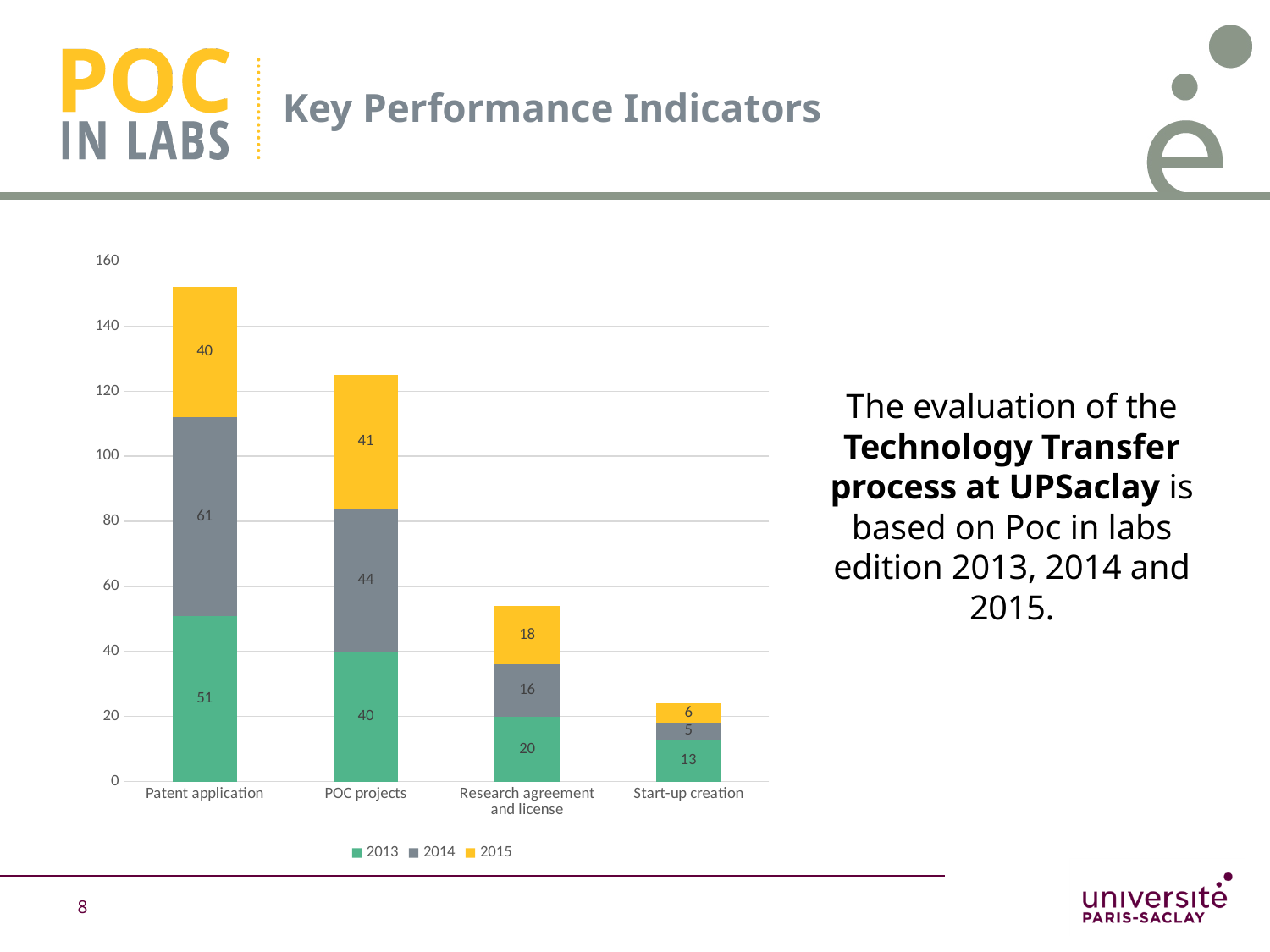
What is the total of the stacked bar for Start-up creation? 24 What is the total of the stacked bar for Research agreement and license? 54 How many series does the legend list? 3 What is the 2014 value for Research agreement and license? 16 Which category has the highest total across all years? Patent application Which category has the lowest total across all years? Start-up creation What is the difference between the 2014 value for Patent application and the 2014 value for POC projects? 17 What is the 2013 value for Patent application? 51 What kind of chart is shown on the slide? Stacked bar chart Which is larger: the 2015 value for Patent application or the 2015 value for Research agreement and license? Patent application What is the 2015 value for POC projects? 41 What is the 2014 value for Start-up creation? 5